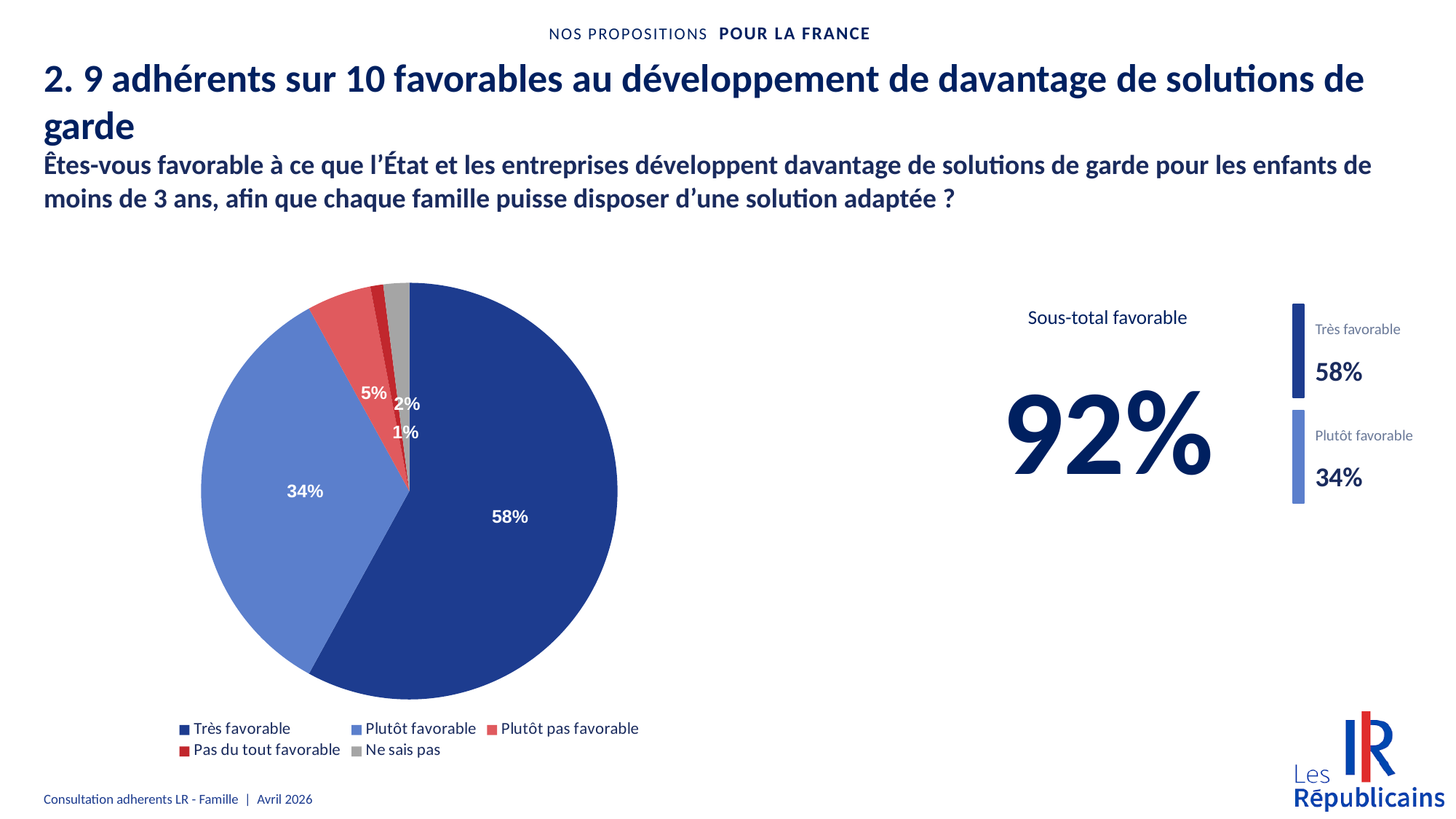
Which category has the largest slice of the pie? Très favorable Which is larger, 'Plutôt pas favorable' or 'Ne sais pas'? Plutôt pas favorable What share of the pie is 'Très favorable'? 58% What kind of chart is shown on the slide? pie chart What share of the pie is 'Plutôt pas favorable'? 5% What colour is the 'Ne sais pas' slice in the pie chart? grey How many categories does the pie chart legend list? 5 What is the 'Sous-total favorable' value shown next to the pie chart? 92% What share of the pie is 'Plutôt favorable'? 34% What is the difference in percentage points between 'Très favorable' and 'Plutôt favorable'? 24 What share of the pie is 'Ne sais pas'? 2% Which category has the smallest slice of the pie? Pas du tout favorable